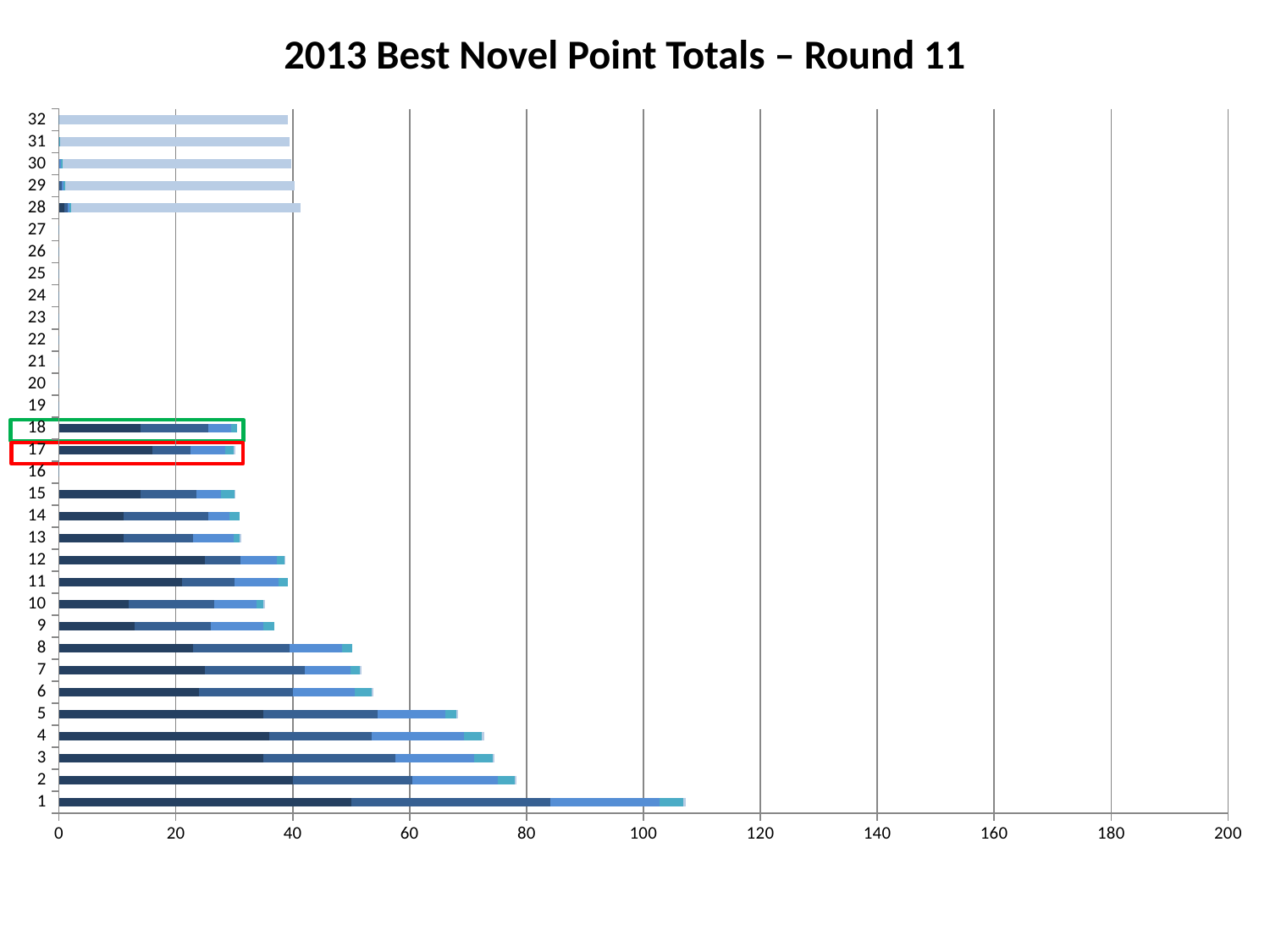
How many categories are listed on the vertical axis of the chart? 32 Is the total value for category 5 greater or less than 60? greater What kind of chart is shown on the slide? bar chart Which category has the longest bar in the chart? 1 Is the total value for category 10 greater or less than 40? less Is the total value for category 8 greater or less than 40? greater Which has the larger total, category 1 or category 2? 1 Which category's bar is outlined with a red box? 17 What is the title of the chart? 2013 Best Novel Point Totals – Round 11 Which has the larger total, category 8 or category 15? 8